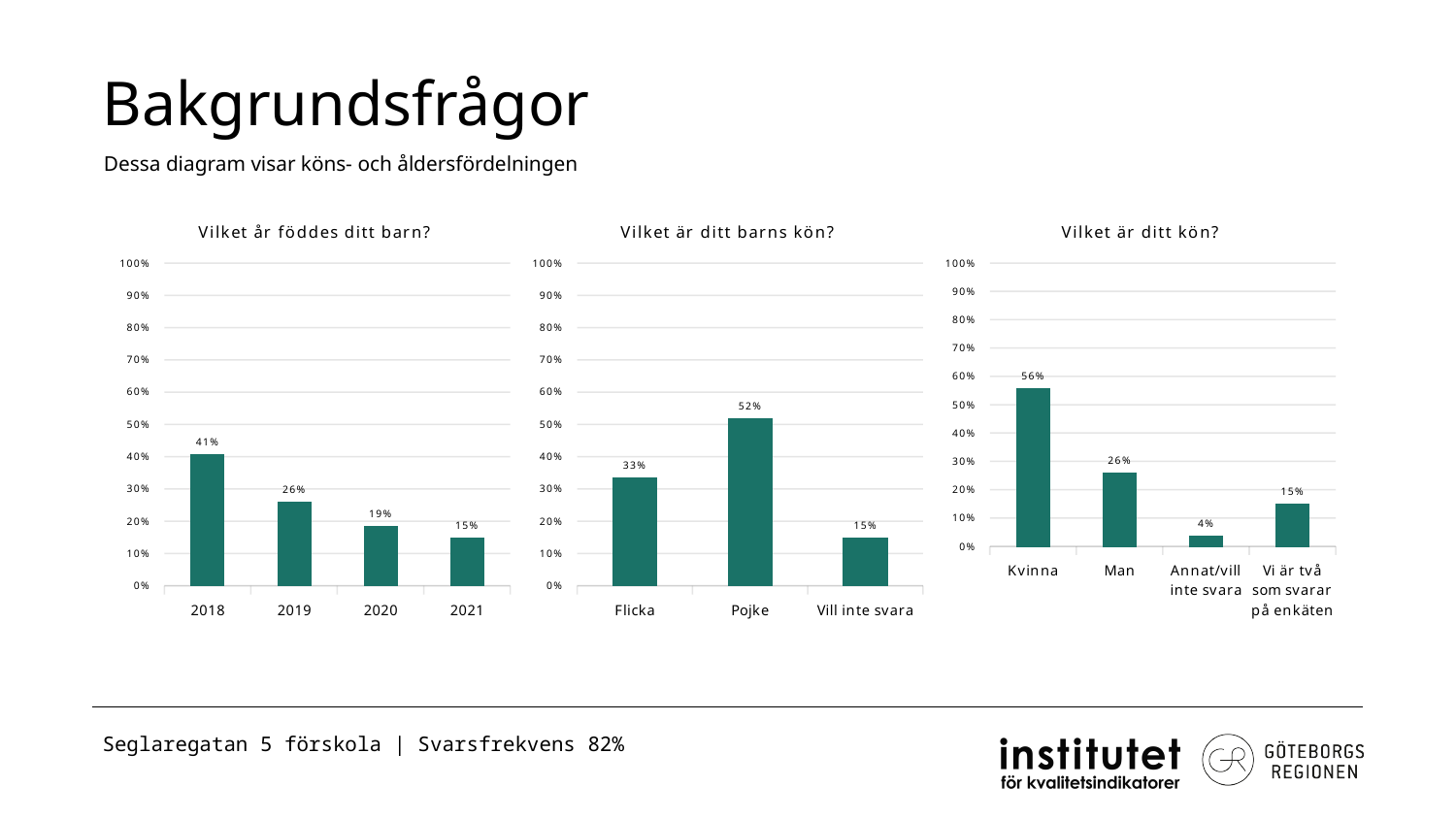
In the chart 'Vilket är ditt kön?', what is the value for Kvinna? 56% In the chart 'Vilket är ditt barns kön?', what is the value for Pojke? 52% In the chart 'Vilket är ditt barns kön?', which category has the highest value? Pojke In the chart 'Vilket år föddes ditt barn?', what is the difference between the values for 2019 and 2020? 7% In the chart 'Vilket år föddes ditt barn?', how many categories are shown on the x axis? 4 In the chart 'Vilket år föddes ditt barn?', what is the value for 2018? 41% In the chart 'Vilket år föddes ditt barn?', do the values rise or fall from 2018 to 2021? fall What kind of chart is 'Vilket är ditt kön?'? bar chart In the chart 'Vilket är ditt kön?', what is the difference between the values for Kvinna and Man? 30% In the chart 'Vilket är ditt kön?', which category has the lowest value? Annat/vill inte svara In the chart 'Vilket är ditt barns kön?', which is larger, Flicka or Vill inte svara? Flicka In the chart 'Vilket år föddes ditt barn?', which year has the lowest value? 2021